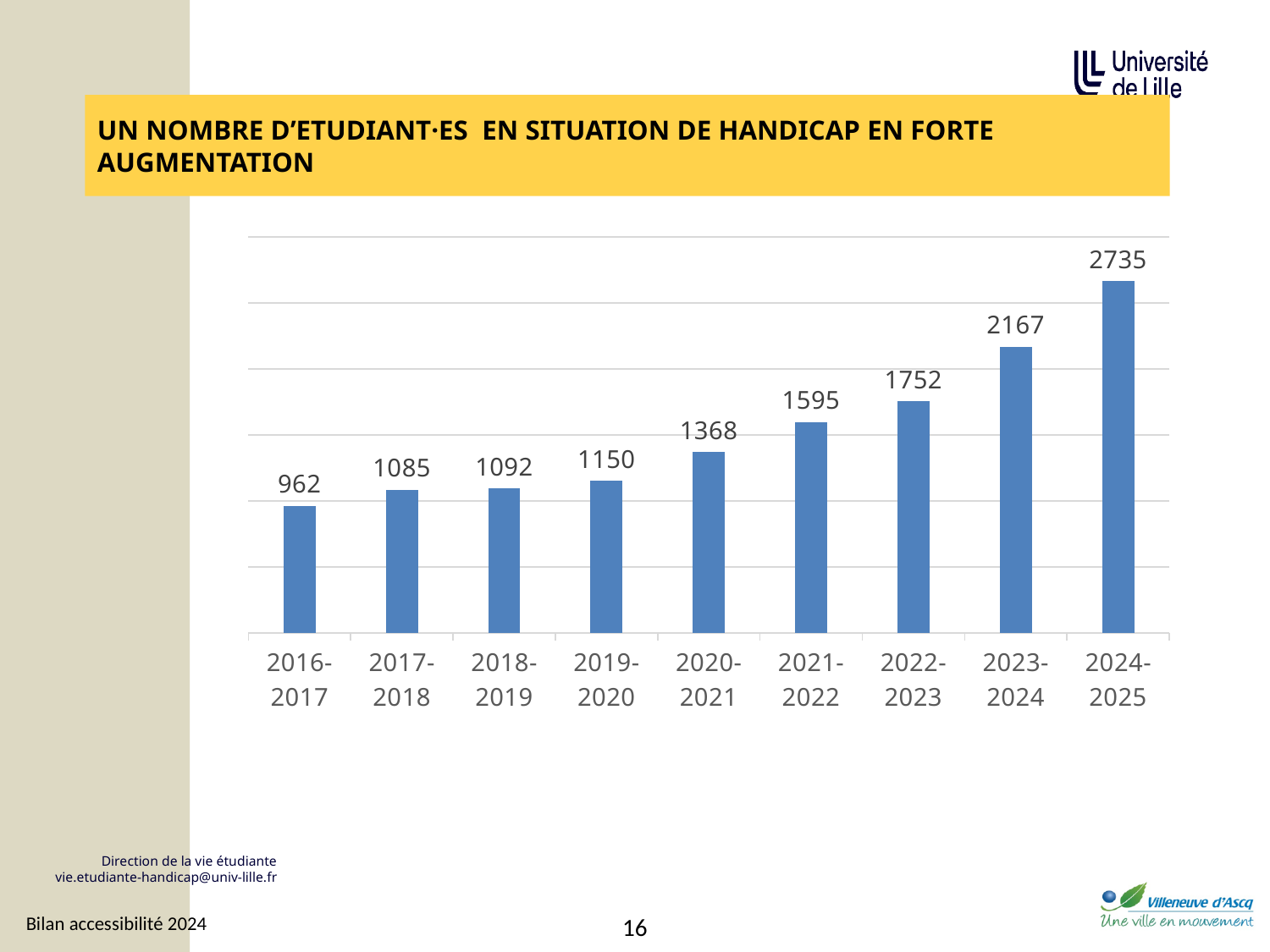
Which year has the lowest value? 2016-2017 Which year has the highest value? 2024-2025 What is the value for 2024-2025? 2735 What is the difference between the values for 2024-2025 and 2023-2024? 568 What kind of chart is shown on the slide? bar chart How many years are shown on the chart? 9 What is the difference between the values for 2021-2022 and 2020-2021? 227 Which is larger, the value for 2018-2019 or the value for 2019-2020? 2019-2020 What is the value for 2020-2021? 1368 What colour are the bars on the chart? blue Do the values rise or fall from 2016-2017 to 2024-2025? rise What is the value for 2016-2017? 962